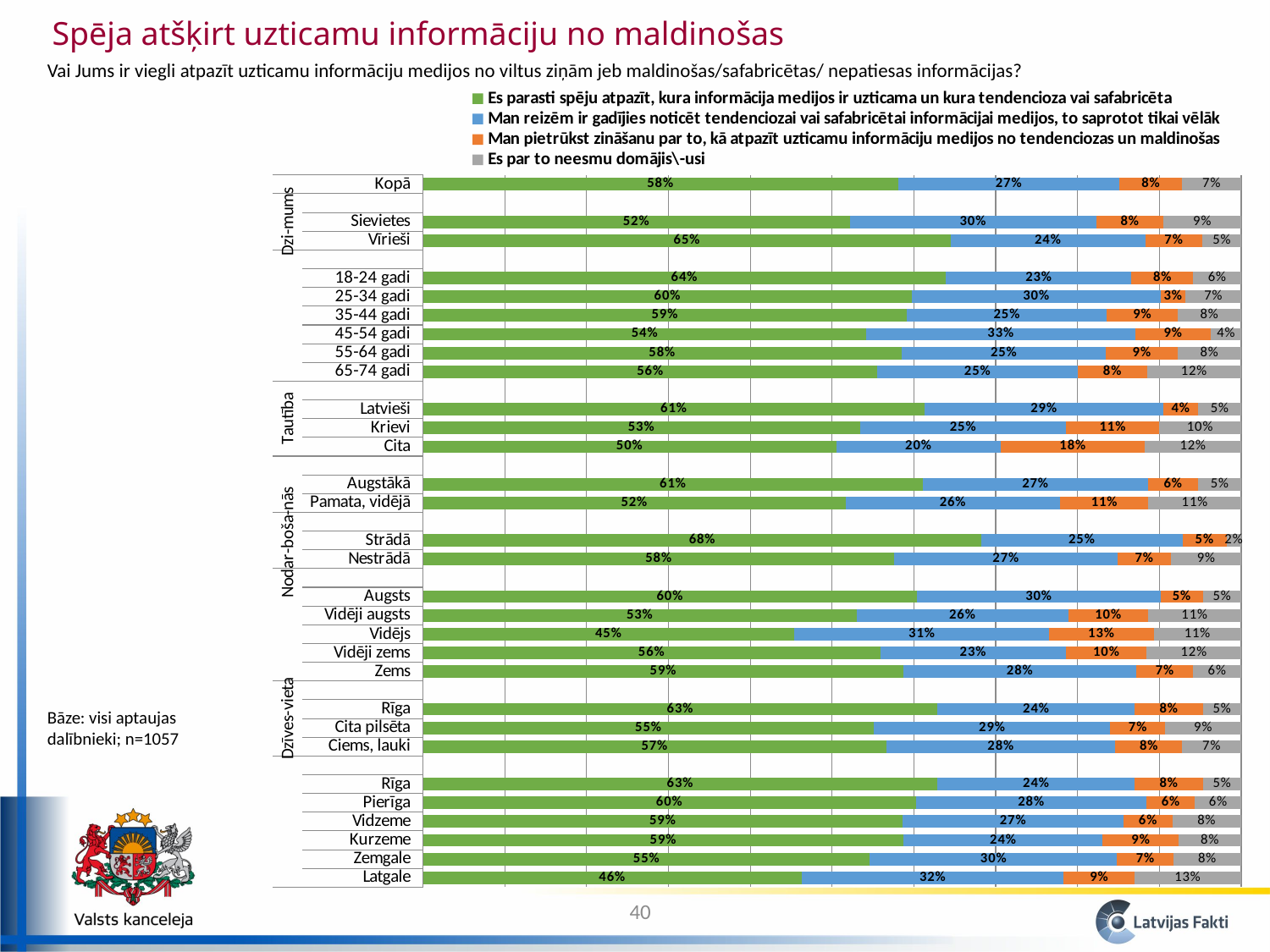
How many series does the legend list? 4 What is the value of the blue series ("Man reizēm ir gadījies...") for Zemgale? 30% What is the value of the green series ("Es parasti spēju atpazīt...") for Kopā? 58% Which category has the highest value in the green series ("Es parasti spēju atpazīt...")? Strādā What is the value of the orange series ("Man pietrūkst zināšanu...") for 25-34 gadi? 3% What is the value of the blue series ("Man reizēm ir gadījies...") for 45-54 gadi? 33% Which category has the lowest value in the green series ("Es parasti spēju atpazīt...")? Vidējs Which has a larger green series value, Latvieši or Krievi? Latvieši What is the difference between the green series values for Vīrieši and Sievietes? 13 percentage points What type of chart is shown on the slide? Stacked bar chart What is the value of the grey series ("Es par to neesmu domājis/-usi") for Latgale? 13% What is the value of the orange series ("Man pietrūkst zināšanu...") for Cita (Tautība)? 18%